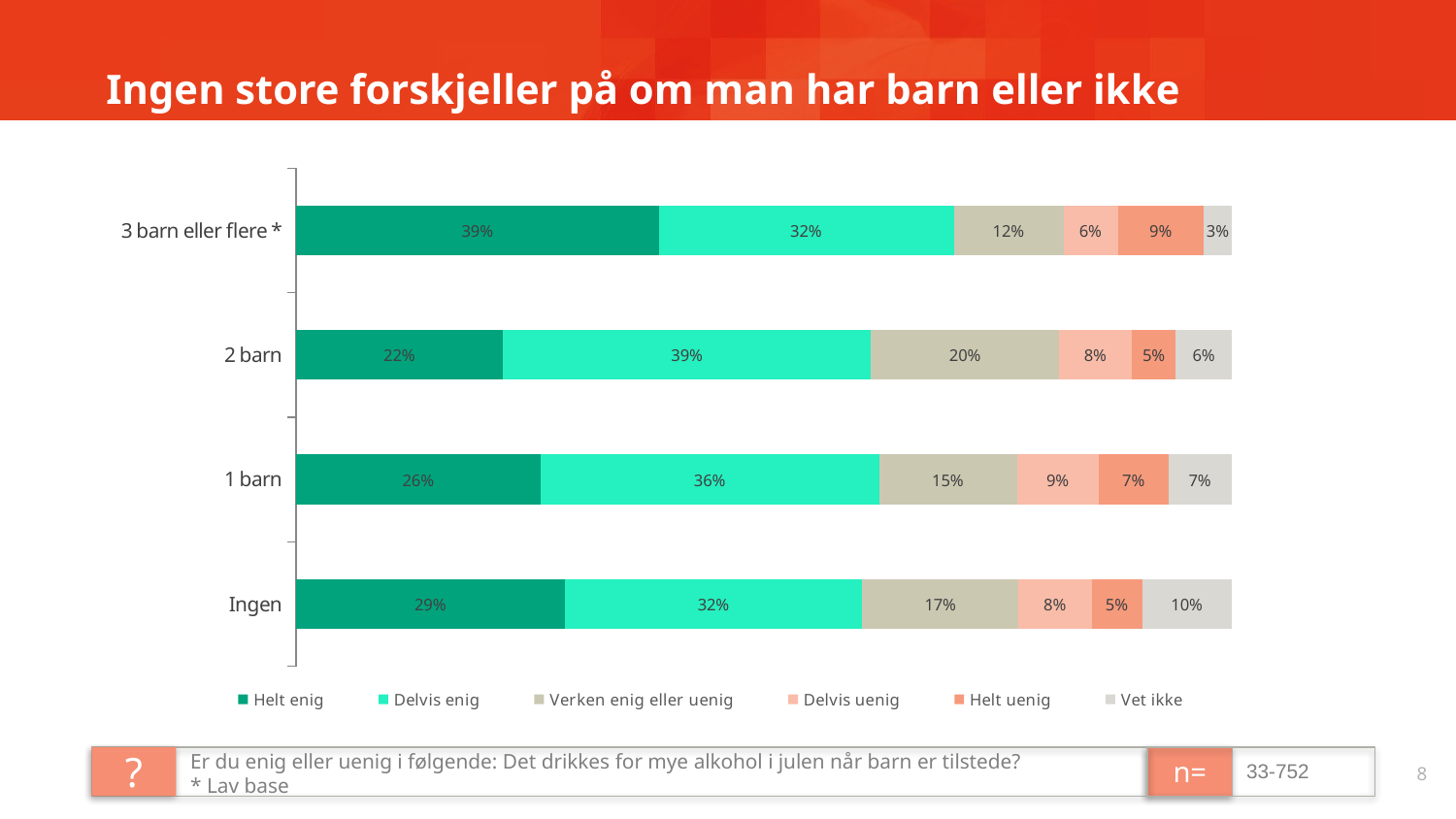
What is the "Delvis enig" value for "1 barn"? 36% How many series does the legend list? 6 What is the difference between the "Helt enig" values for "3 barn eller flere *" and "2 barn"? 17% Which category has the lowest "Vet ikke" value? 3 barn eller flere * What is the "Helt enig" value for "2 barn"? 22% What kind of chart is shown on the slide? Stacked bar chart How many categories are shown on the chart? 4 Which is larger: the "Helt uenig" value for "3 barn eller flere *" or for "1 barn"? 3 barn eller flere * What is the "Vet ikke" value for "Ingen"? 10% Which category has the highest "Helt enig" value? 3 barn eller flere * What is the "Verken enig eller uenig" value for "3 barn eller flere *"? 12% What is the title of the slide? Ingen store forskjeller på om man har barn eller ikke